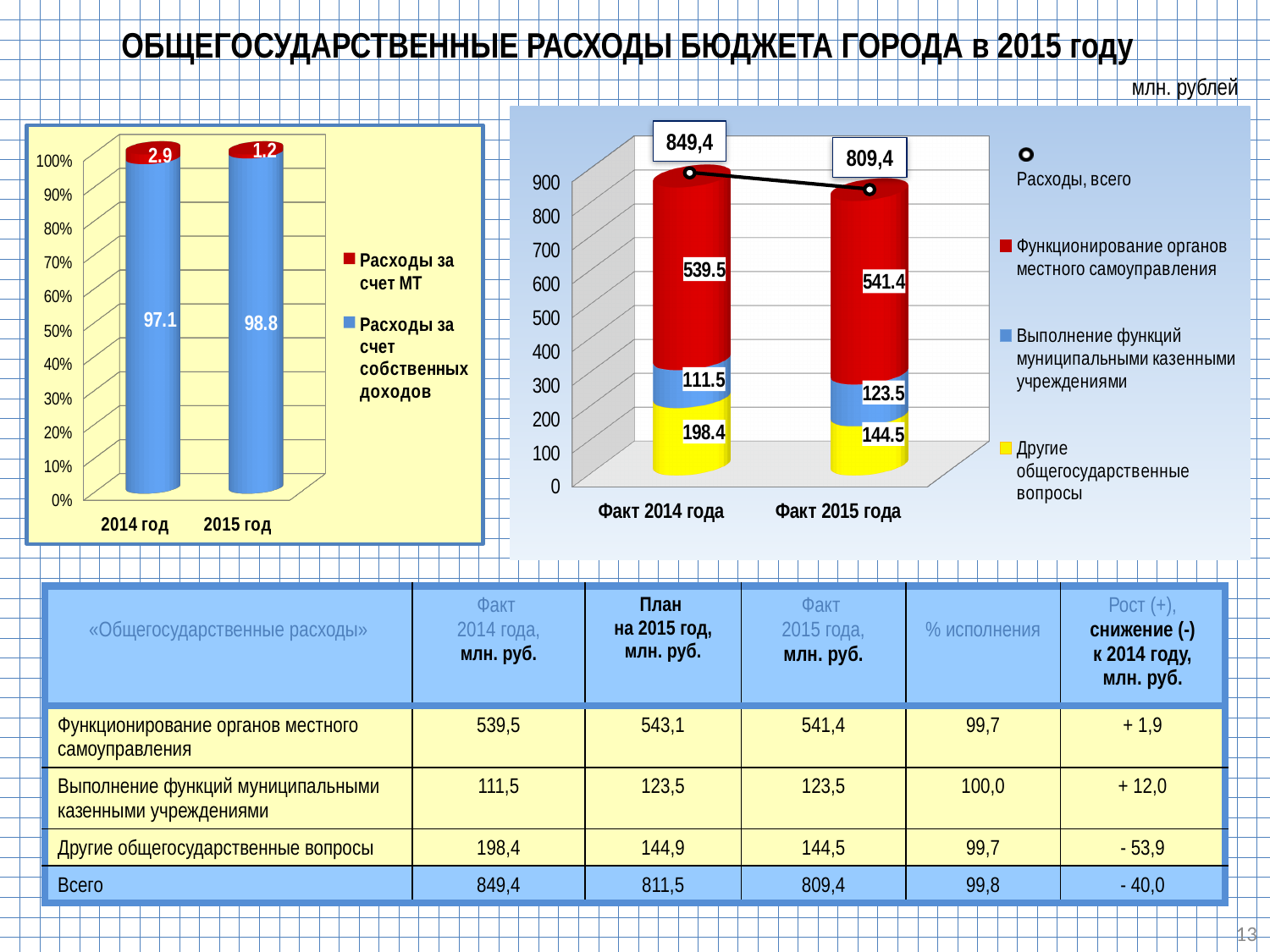
How many series does the legend of the left chart list? 2 What kind of chart is the left chart? bar chart How many categories are shown on the x axis of the right chart? 2 How many entries does the legend of the right chart list? 4 In the right chart, does Расходы, всего rise or fall from Факт 2014 года to Факт 2015 года? fall In the right chart, what is the value of Расходы, всего for Факт 2014 года? 849,4 In the left chart, what is the value for Расходы за счет МТ in 2014 год? 2.9 In the right chart, which is larger for Выполнение функций муниципальными казенными учреждениями: Факт 2014 года or Факт 2015 года? Факт 2015 года In the left chart, what is the value for Расходы за счет собственных доходов in 2015 год? 98.8 In the right chart, what is the value for Функционирование органов местного самоуправления for Факт 2015 года? 541.4 In the right chart, what is the value for Другие общегосударственные вопросы for Факт 2014 года? 198.4 In the right chart, what is the difference between Другие общегосударственные вопросы for Факт 2014 года and Факт 2015 года? 53.9